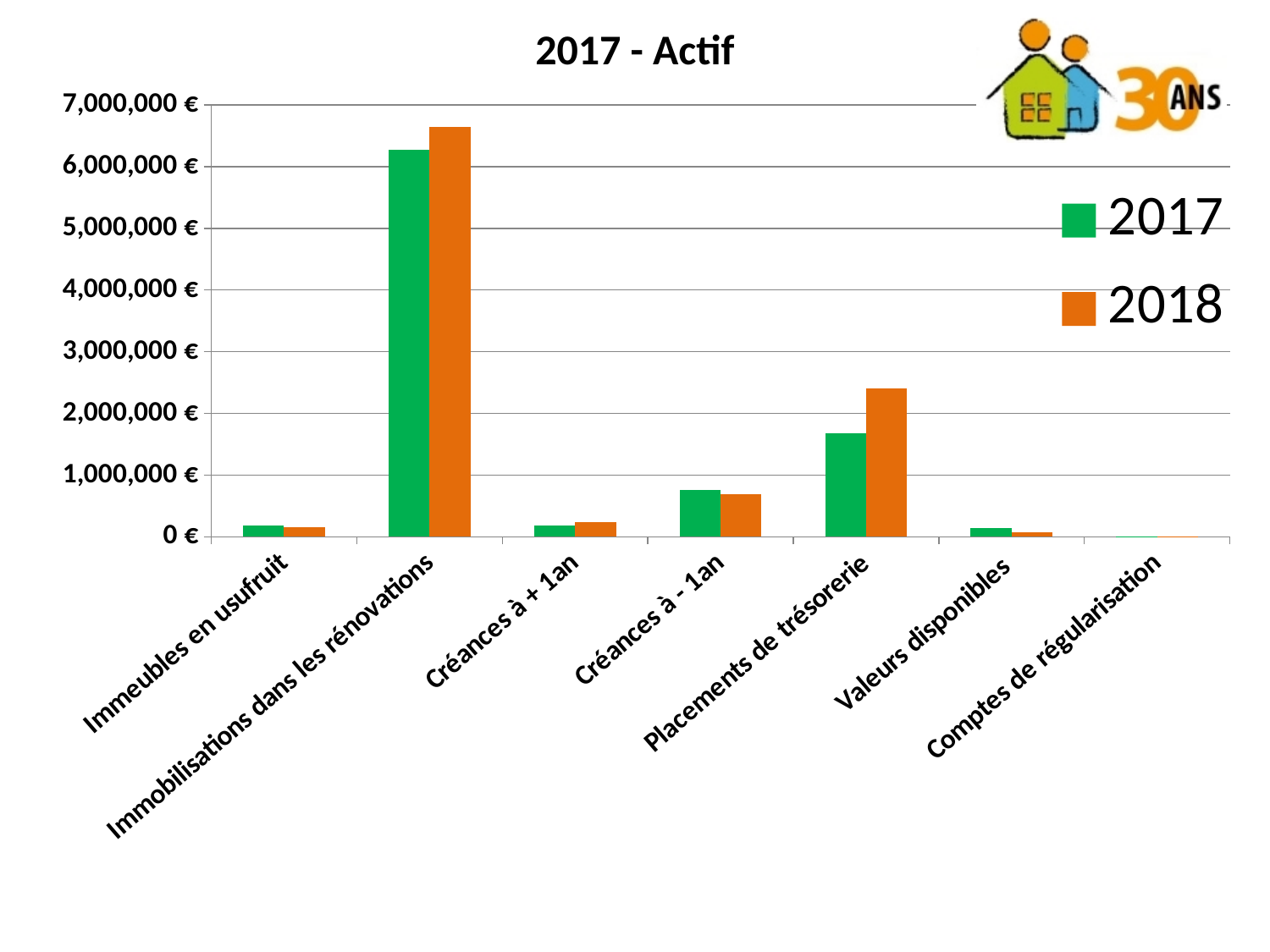
Is the 2018 value for Immobilisations dans les rénovations greater or less than 6,000,000 €? greater How many series does the legend list? 2 Which category has the lowest value for 2017? Comptes de régularisation What kind of chart is shown on the slide? bar chart Which category has the highest value for 2018? Immobilisations dans les rénovations For Valeurs disponibles, which year has the larger value, 2017 or 2018? 2017 Is the 2017 value for Placements de trésorerie greater or less than 2,000,000 €? less Is the 2017 value for Créances à - 1an greater or less than 1,000,000 €? less For Placements de trésorerie, which year has the larger value, 2017 or 2018? 2018 What is the title of the chart? 2017 - Actif How many categories are shown on the x axis? 7